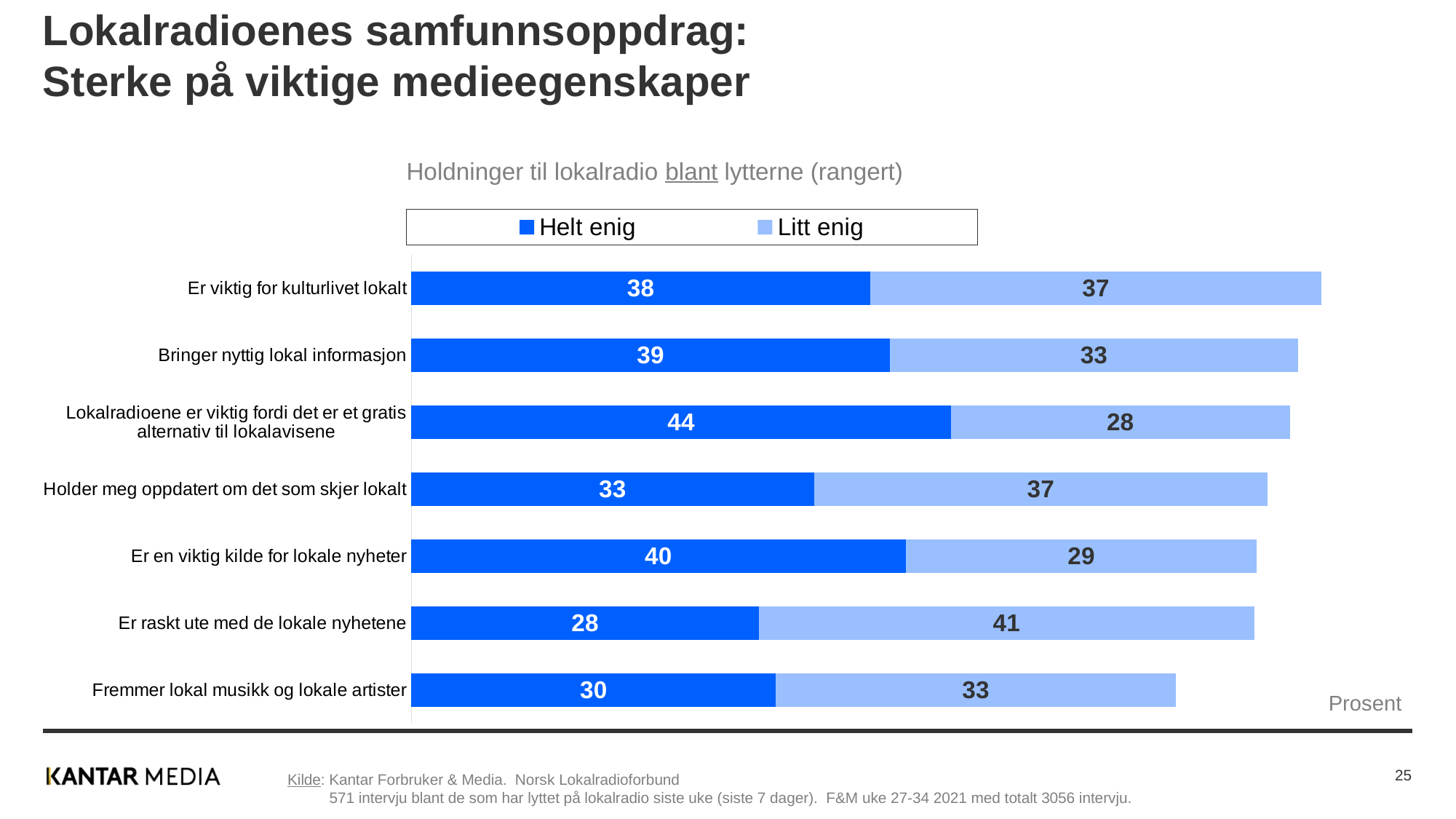
Which category has the lowest 'Helt enig' value? Er raskt ute med de lokale nyhetene What is the difference between the 'Helt enig' and 'Litt enig' values for 'Lokalradioene er viktig fordi det er et gratis alternativ til lokalavisene'? 16 What is the 'Helt enig' value for 'Er viktig for kulturlivet lokalt'? 38 What is the total of the stacked bar for 'Fremmer lokal musikk og lokale artister'? 63 What is the 'Helt enig' value for 'Fremmer lokal musikk og lokale artister'? 30 What is the total of the stacked bar for 'Er viktig for kulturlivet lokalt'? 75 Which is larger for 'Holder meg oppdatert om det som skjer lokalt': the 'Helt enig' value or the 'Litt enig' value? Litt enig How many series does the legend list? 2 How many categories are shown in the chart? 7 Which category has the highest 'Helt enig' value? Lokalradioene er viktig fordi det er et gratis alternativ til lokalavisene What is the 'Litt enig' value for 'Er raskt ute med de lokale nyhetene'? 41 Which category has the highest 'Litt enig' value? Er raskt ute med de lokale nyhetene